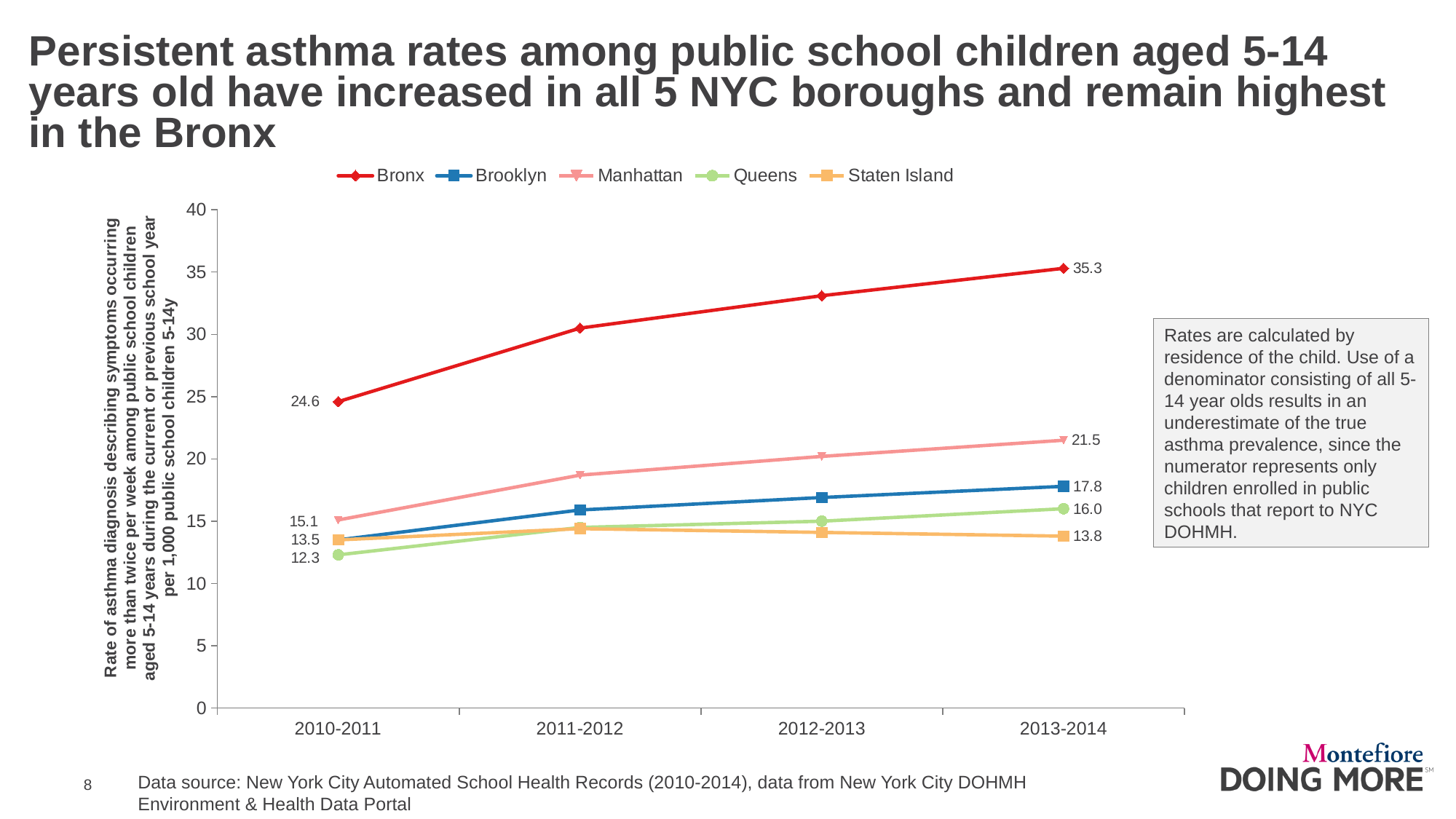
What kind of chart is shown on the slide? Line chart Which borough has the lowest persistent asthma rate in 2013-2014? Staten Island What is the persistent asthma rate for Queens in 2010-2011? 12.3 In 2013-2014, which has the higher persistent asthma rate, Brooklyn or Queens? Brooklyn What is the persistent asthma rate for the Bronx in 2010-2011? 24.6 How many boroughs (series) does the legend list? 5 Is the Bronx persistent asthma rate in 2012-2013 greater or less than 30? greater By how much did the Bronx persistent asthma rate increase from 2010-2011 to 2013-2014? 10.7 What is the persistent asthma rate for Manhattan in 2013-2014? 21.5 What is the persistent asthma rate for Staten Island in 2013-2014? 13.8 What is the persistent asthma rate for the Bronx in 2013-2014? 35.3 Which borough has the highest persistent asthma rate in 2013-2014? Bronx